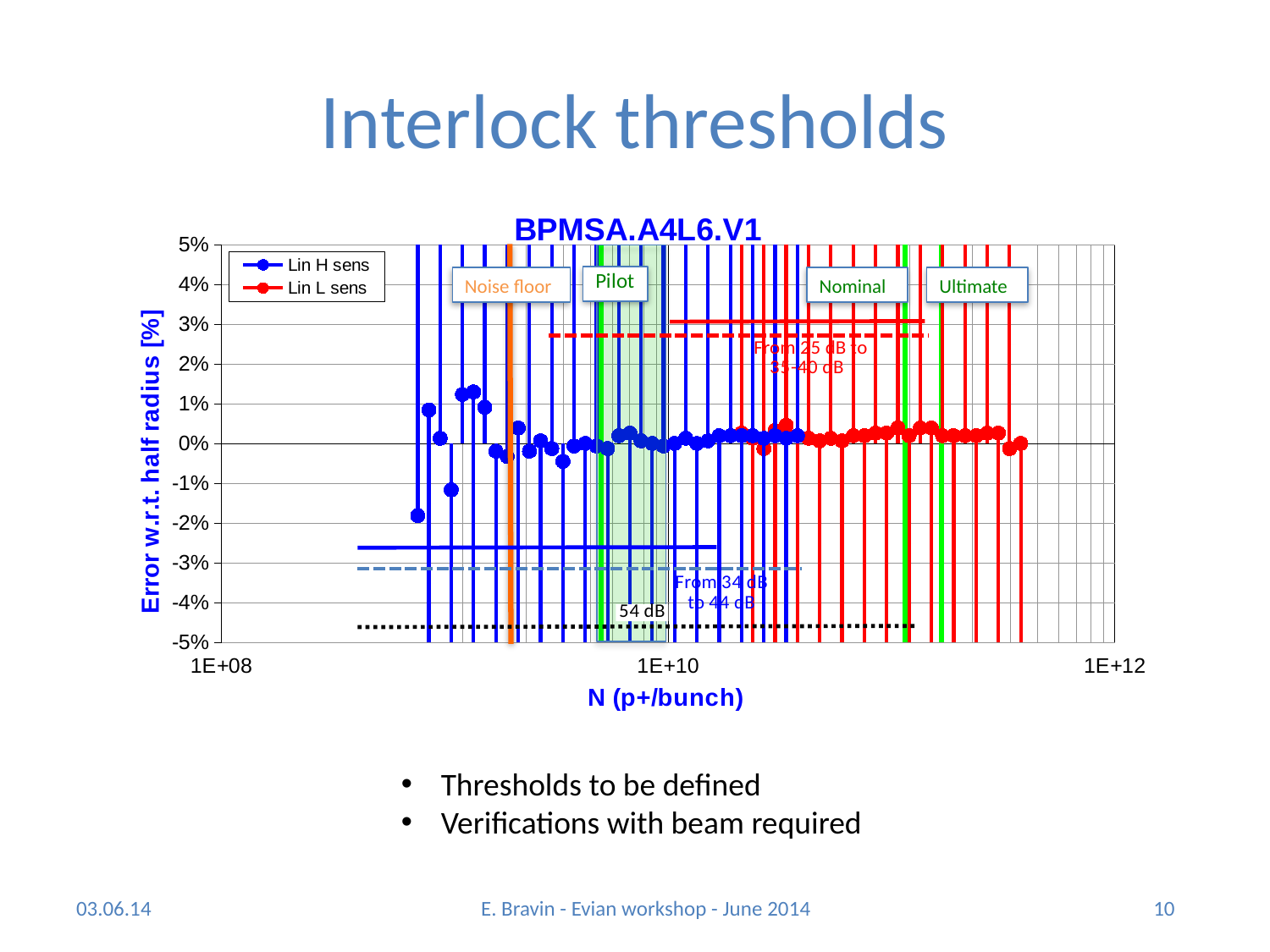
Is the highest Lin H sens point greater or less than 1%? greater Is the lowest Lin H sens point greater or less than -1%? less Which series, Lin H sens or Lin L sens, reaches the higher maximum value? Lin H sens Which series, Lin H sens or Lin L sens, reaches the lower minimum value? Lin H sens Is the lowest Lin L sens point greater or less than -1%? greater What kind of chart is shown on the slide? line chart How many series does the chart legend list? 2 What is the title of the chart? BPMSA.A4L6.V1 What are the two series names listed in the chart legend? Lin H sens, Lin L sens